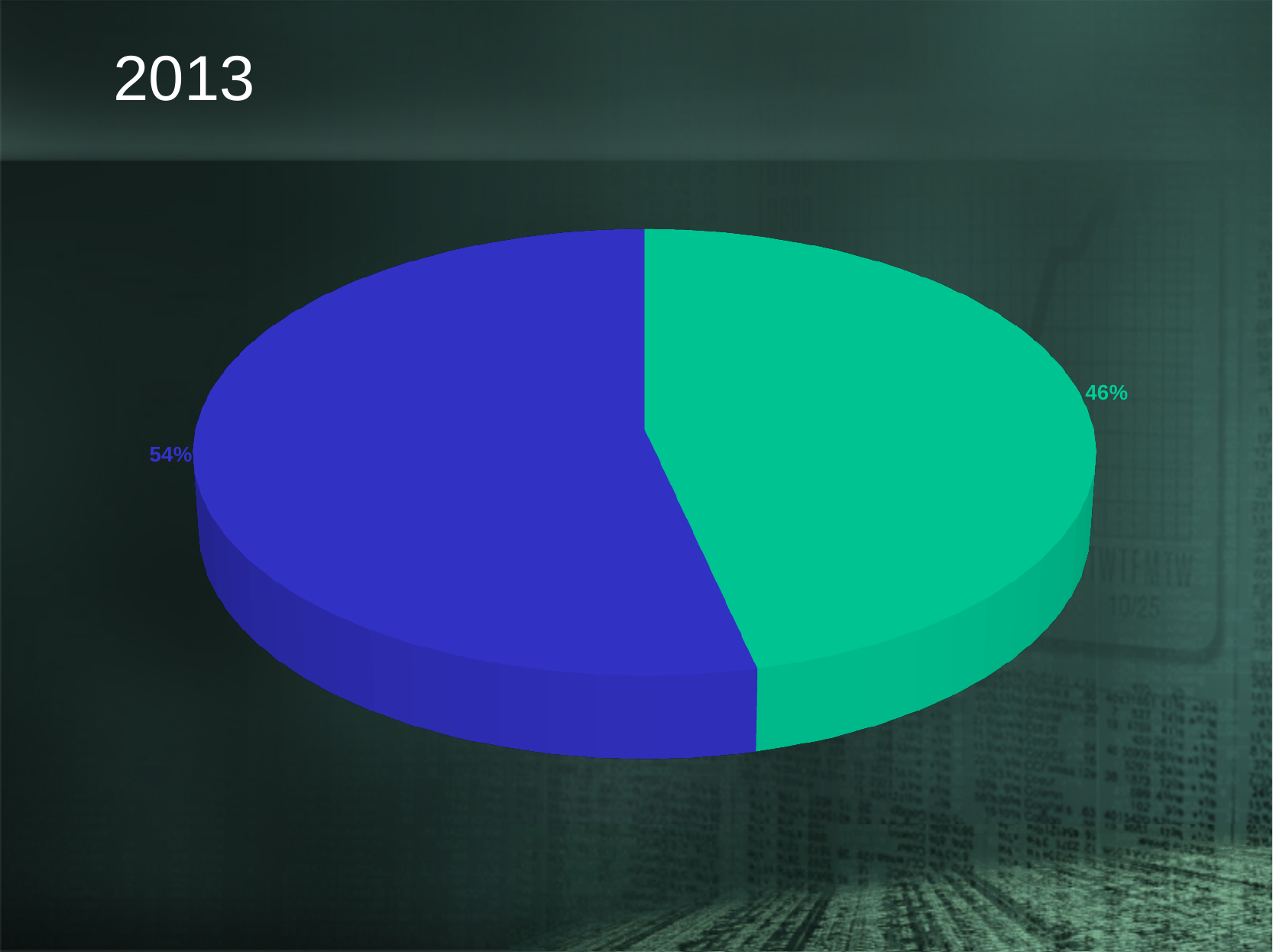
Does the pie chart include a legend? No What percentage is shown for the green slice of the pie chart? 46% What percentage is shown for the blue slice of the pie chart? 54% What is the difference in percentage points between the blue slice and the green slice? 8 percentage points What is the title shown on the slide above the pie chart? 2013 What kind of chart is shown on the slide? pie chart Which is larger, the blue slice or the green slice? the blue slice What share of the pie does the green slice represent? 46% Which slice of the pie chart is the smallest? the green slice (46%) Which slice of the pie chart is the largest? the blue slice (54%) How many slices does the pie chart have? 2